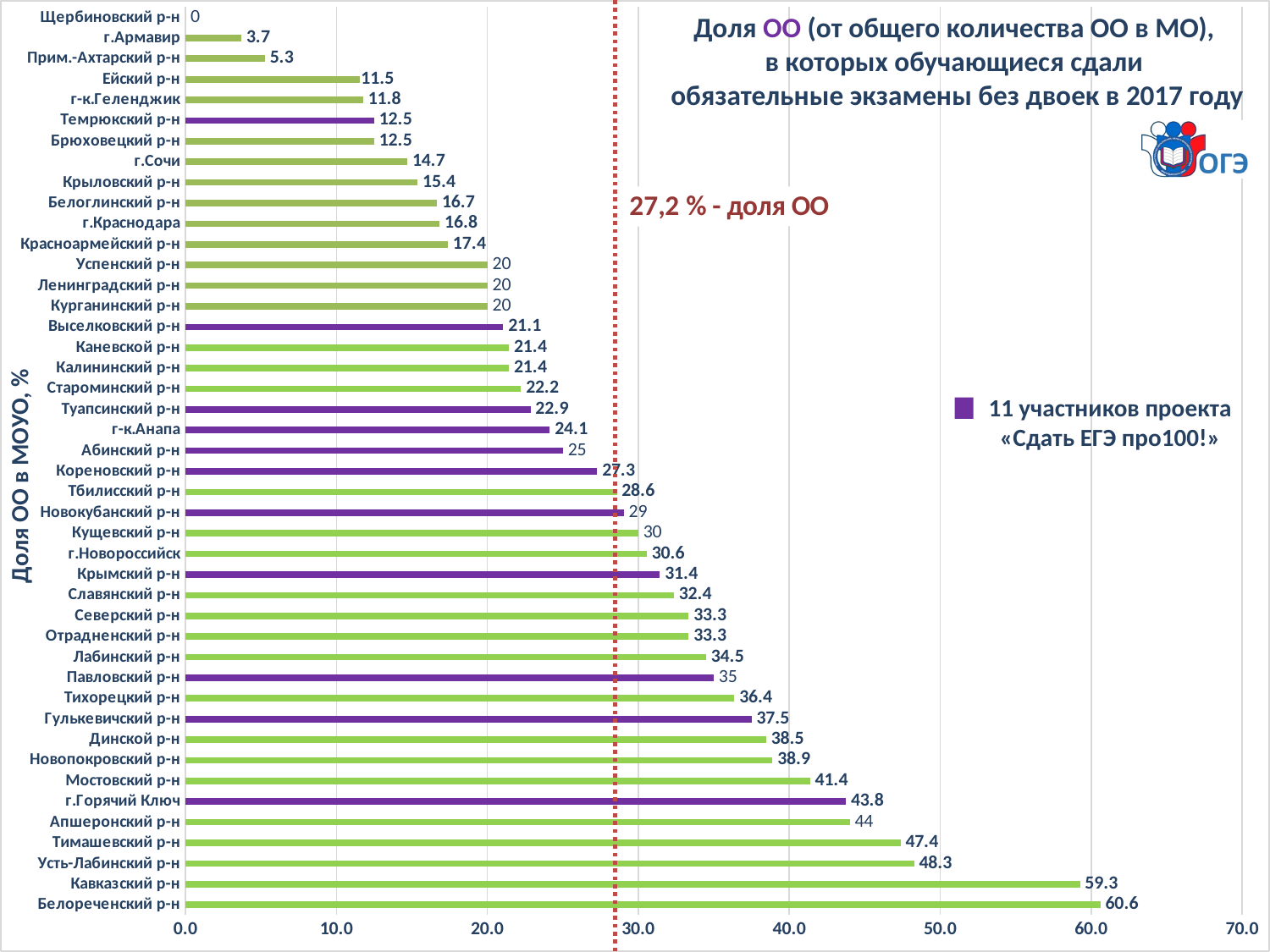
What is the value for Белореченский р-н? 60.6 What value does the red dotted vertical line mark, according to the label on the chart? 27,2 % What is the value for г.Горячий Ключ? 43.8 What is the difference between the values for Кавказский р-н and Усть-Лабинский р-н? 11 How many categories are plotted on the chart? 44 What is the value for г.Сочи? 14.7 Which has a larger value, Тихорецкий р-н or Лабинский р-н? Тихорецкий р-н What type of chart is shown on the slide? bar chart Which category has the lowest value? Щербиновский р-н Which category has the highest value? Белореченский р-н Is the value for Мостовский р-н greater or less than 40? greater According to the legend, what do the purple bars represent? 11 участников проекта «Сдать ЕГЭ про100!»